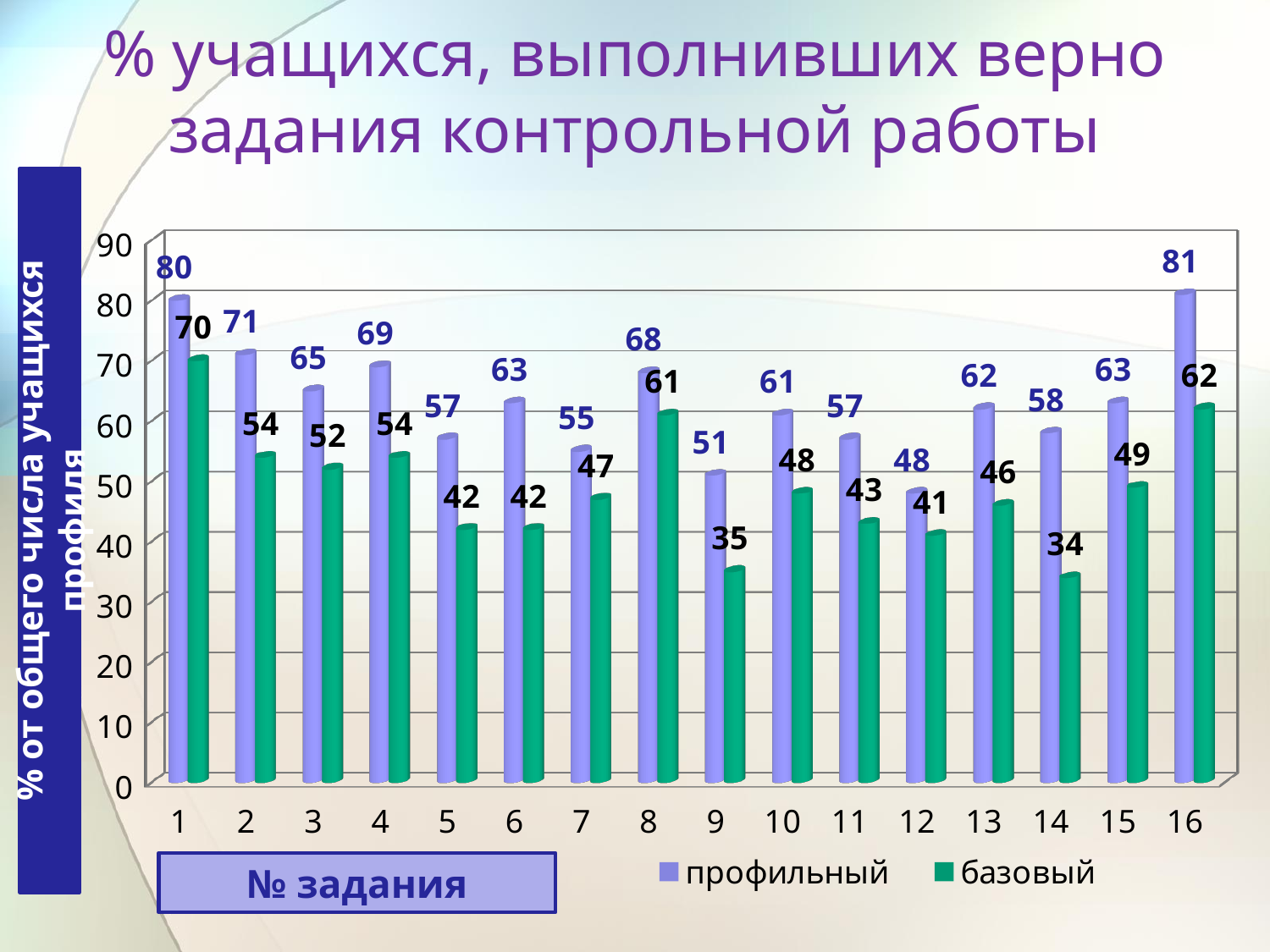
Which task has the highest value for базовый? 1 How many tasks are shown on the x axis? 16 What is the x-axis label of the chart? № задания What kind of chart is shown on the slide? bar chart Which task has the lowest value for базовый? 14 What is the difference between профильный and базовый for task 14? 24 What is the value for базовый for task 9? 35 How many series does the legend list? 2 What is the value for профильный for task 12? 48 Which is larger for task 5: профильный or базовый? профильный Which task has the highest value for профильный? 16 What is the value for профильный for task 8? 68